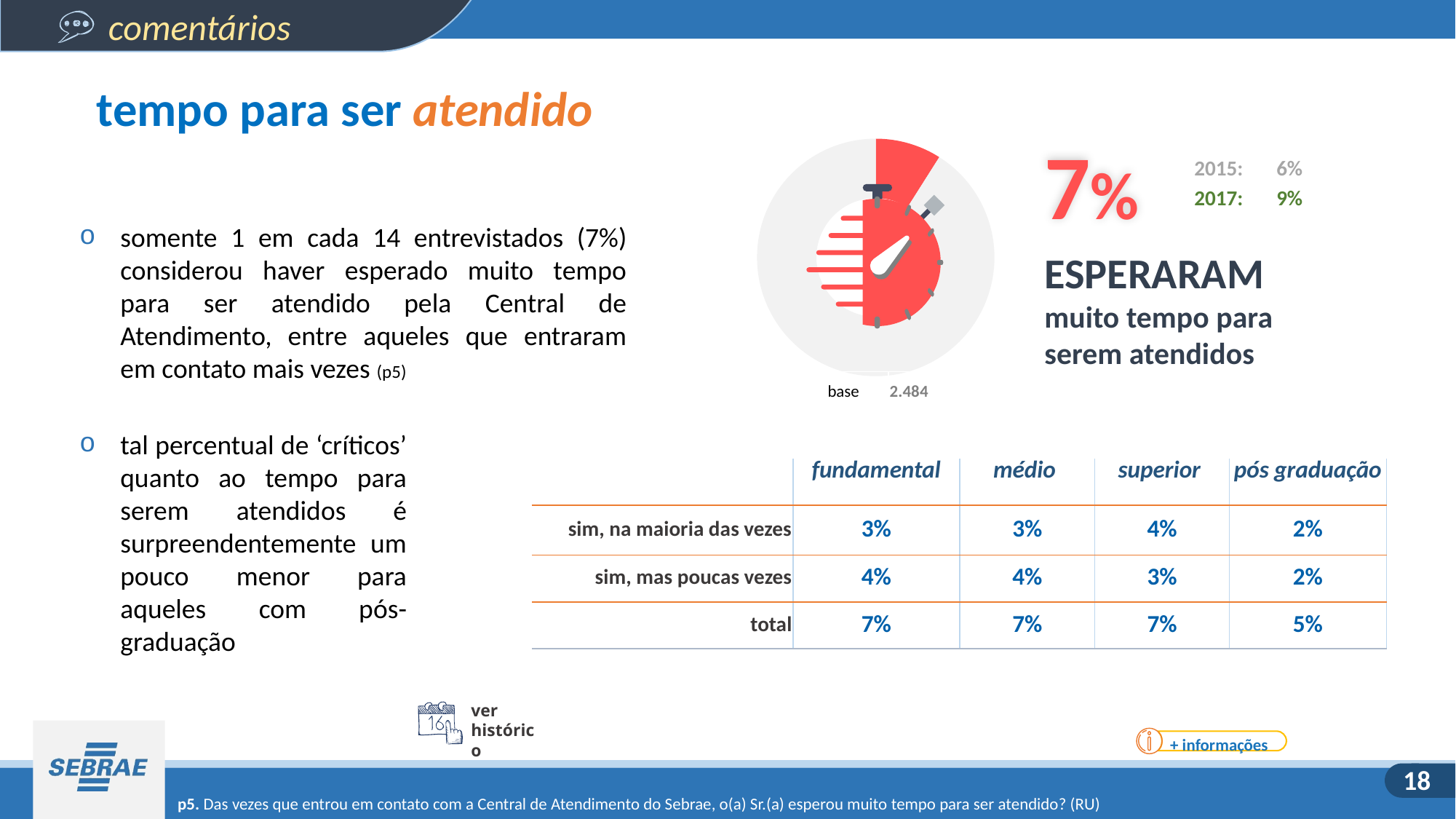
In the table, what is the value for 'sim, na maioria das vezes' in the 'superior' column? 4% How many education-level columns does the table have? 4 What percentage of respondents said they waited a long time to be served, as shown in the stopwatch chart? 7% In the table, which education level has the lowest total? pós graduação What is the base (number of respondents) shown under the stopwatch chart? 2.484 Is the 7% value in the stopwatch chart greater or less than 10%? less What colour is the highlighted slice of the stopwatch chart? red What is the difference between the 2017 value and the 2015 value shown next to the stopwatch chart? 3% Which year shown next to the stopwatch chart had the higher value, 2015 or 2017? 2017 What was the value for 2015 shown next to the stopwatch chart? 6% What was the value for 2017 shown next to the stopwatch chart? 9% In the table, what is the total for 'pós graduação'? 5%